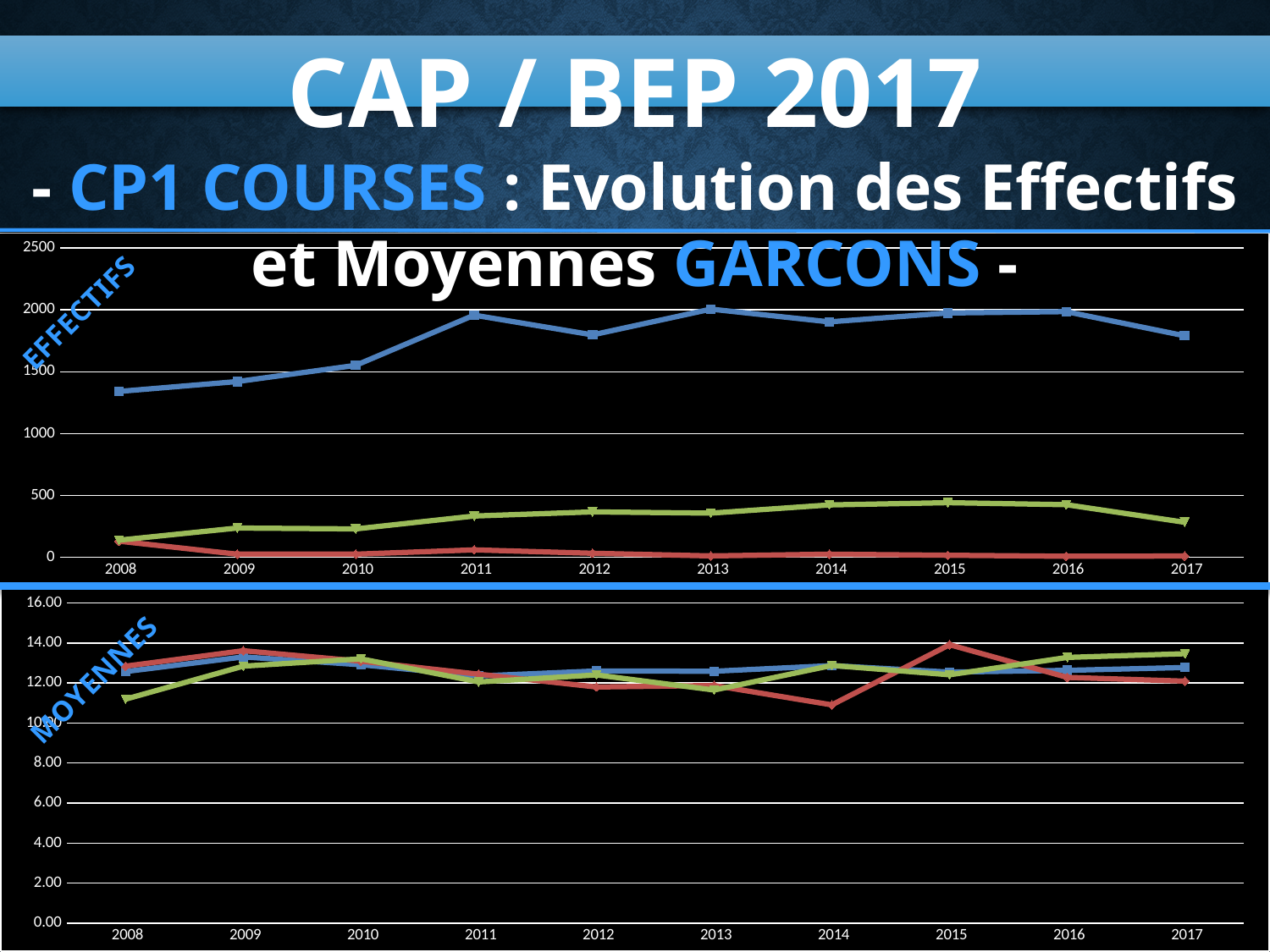
In the top chart (EFFECTIFS), is the value of the green line for 2015 greater or less than 500? less In the top chart (EFFECTIFS), in which year is the blue line at its lowest? 2008 In the top chart (EFFECTIFS), is the value of the blue line for 2013 greater or less than 1500? greater What is the label written along the vertical axis of the top chart? EFFECTIFS In the top chart (EFFECTIFS), how many years are shown on the x axis? 10 What kind of chart is the top chart labelled EFFECTIFS? line chart In the top chart (EFFECTIFS), does the blue line rise or fall between 2008 and 2011? rise In the bottom chart (MOYENNES), which line has the larger value in 2014, the red line or the green line? green line In the bottom chart (MOYENNES), in which year is the red line at its highest? 2015 In the bottom chart (MOYENNES), is the value of the green line for 2008 greater or less than 12.00? less In the bottom chart (MOYENNES), in which year is the red line at its lowest? 2014